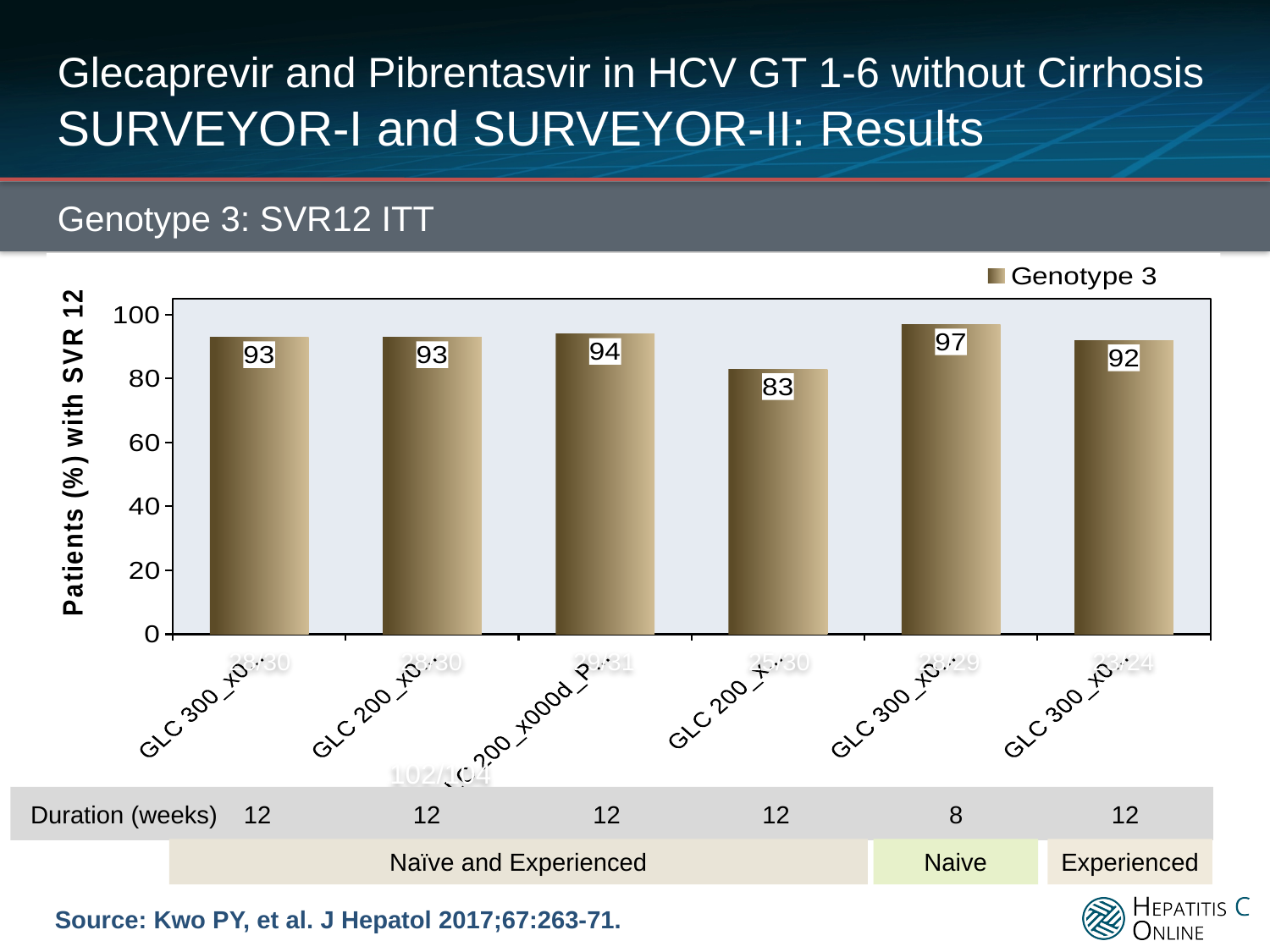
How many bars are plotted in the chart? 6 Is the value of the fourth bar from the left greater or less than 80? greater What is the SVR12 value shown for the bar with an 8-week duration (the Naive group)? 97 Which bar has the lowest SVR12 value? The fourth bar from the left, 83 What is the value labelled on the fourth bar from the left? 83 How many series does the legend list? 1 Which bar has the highest SVR12 value? The fifth bar from the left (8-week Naive group), 97 What is the value labelled on the third bar from the left? 94 What kind of chart is shown on the slide? Bar chart What is the difference between the highest bar value (97) and the lowest bar value (83)? 14 Which is larger: the value of the third bar from the left or the value of the rightmost bar? The third bar from the left (94) What is the SVR12 value shown for the rightmost bar (the Experienced group, 12 weeks)? 92